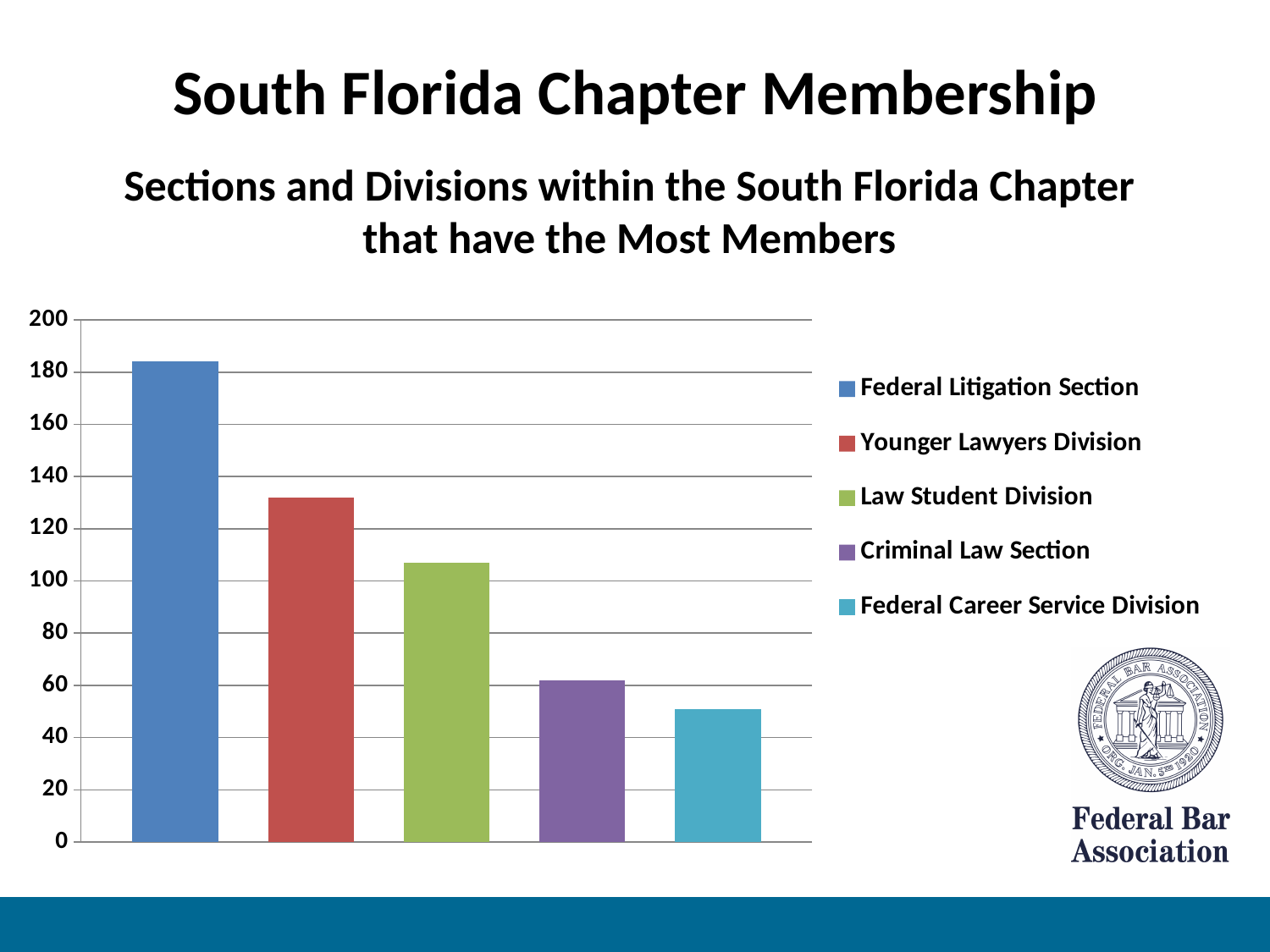
Which section or division has the lowest membership in the chart? Federal Career Service Division How many sections and divisions are plotted in the chart? 5 Is the value for the Younger Lawyers Division greater or less than 120? greater What kind of chart is shown on the slide? bar chart Is the value for the Criminal Law Section greater or less than 80? less Is the value for the Federal Career Service Division greater or less than 60? less Which section or division has the highest membership in the chart? Federal Litigation Section How many entries does the legend list? 5 Do the bar values rise or fall from left to right across the chart? fall Which has more members, the Younger Lawyers Division or the Law Student Division? Younger Lawyers Division